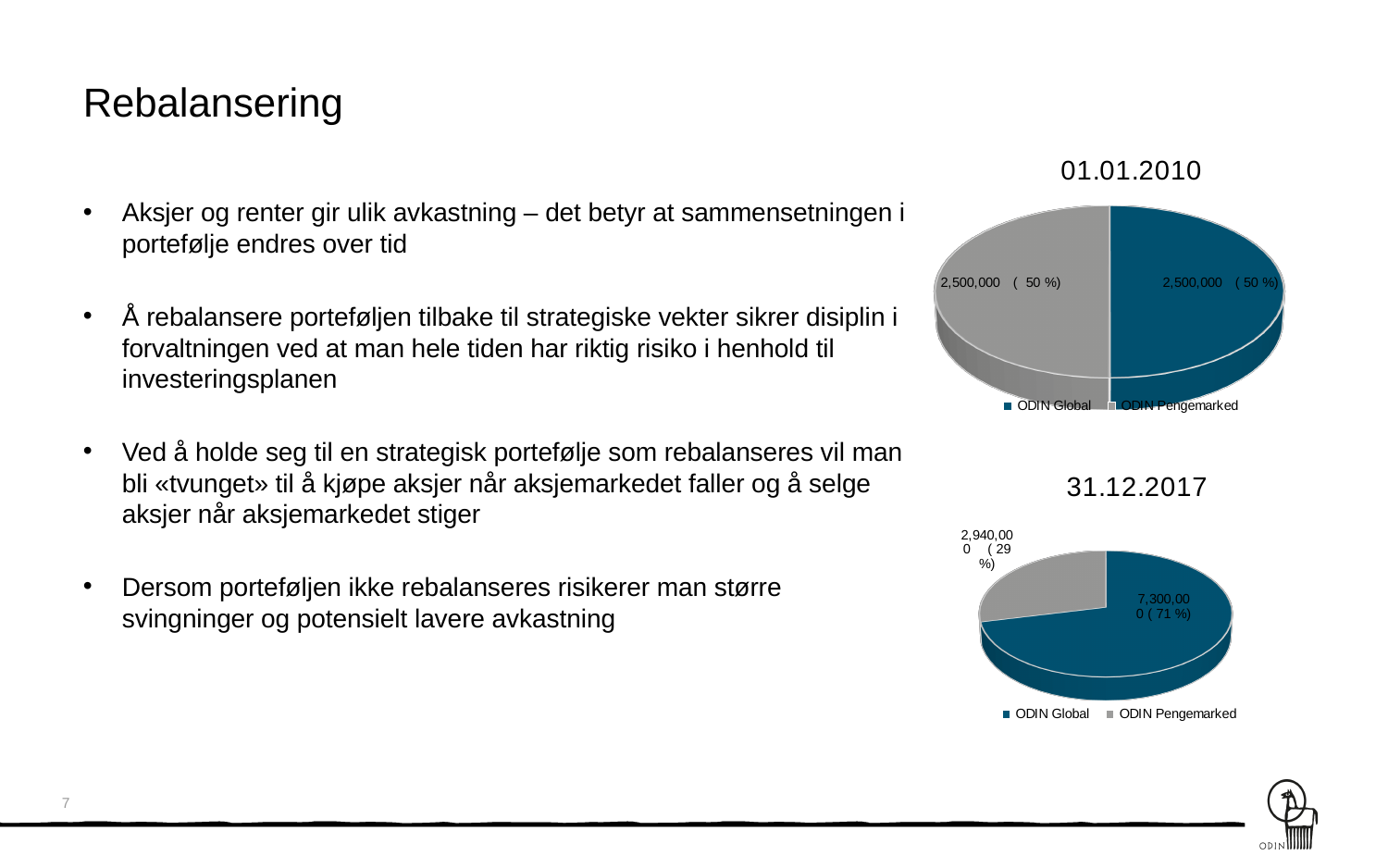
In the chart titled 31.12.2017, which slice is the largest? ODIN Global How many series does the legend list in the chart titled 01.01.2010? 2 In the chart titled 31.12.2017, what value is shown for ODIN Global? 7,300,000 In the chart titled 31.12.2017, what colour is the ODIN Global slice? dark blue In the chart titled 01.01.2010, what value is shown for ODIN Global? 2,500,000 In the chart titled 31.12.2017, what share of the pie does ODIN Global have? 71 % In the chart titled 01.01.2010, what share of the pie does ODIN Pengemarked have? 50 % In the chart titled 31.12.2017, what is the difference between the ODIN Global value and the ODIN Pengemarked value? 4,360,000 In the chart titled 31.12.2017, which is larger, ODIN Global or ODIN Pengemarked? ODIN Global In the chart titled 31.12.2017, what share of the pie does ODIN Pengemarked have? 29 % In the chart titled 31.12.2017, what value is shown for ODIN Pengemarked? 2,940,000 What kind of chart is the chart titled 01.01.2010? pie chart